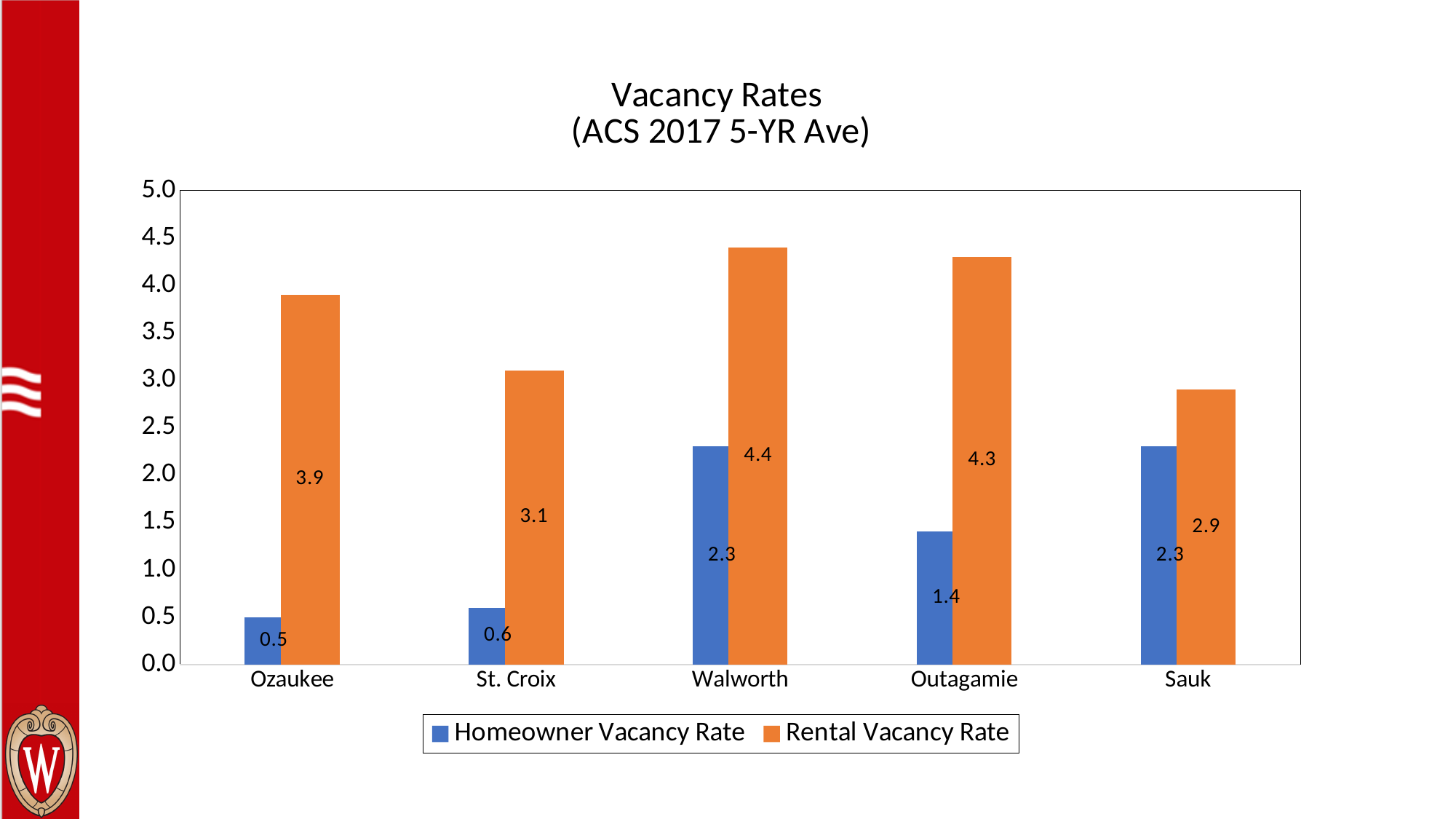
What is the Rental Vacancy Rate for Walworth? 4.4 What is the Homeowner Vacancy Rate for Ozaukee? 0.5 How many series does the legend list? 2 Which county has the highest Rental Vacancy Rate? Walworth Which is larger, the Rental Vacancy Rate for Ozaukee or for St. Croix? Ozaukee Which county has the lowest Rental Vacancy Rate? Sauk What kind of chart is shown on the slide? bar chart Which county has the lowest Homeowner Vacancy Rate? Ozaukee How many counties are shown on the x axis? 5 Is the Rental Vacancy Rate for Outagamie greater or less than 4.0? greater What is the Homeowner Vacancy Rate for Outagamie? 1.4 What is the difference between the Rental Vacancy Rate and the Homeowner Vacancy Rate for Sauk? 0.6